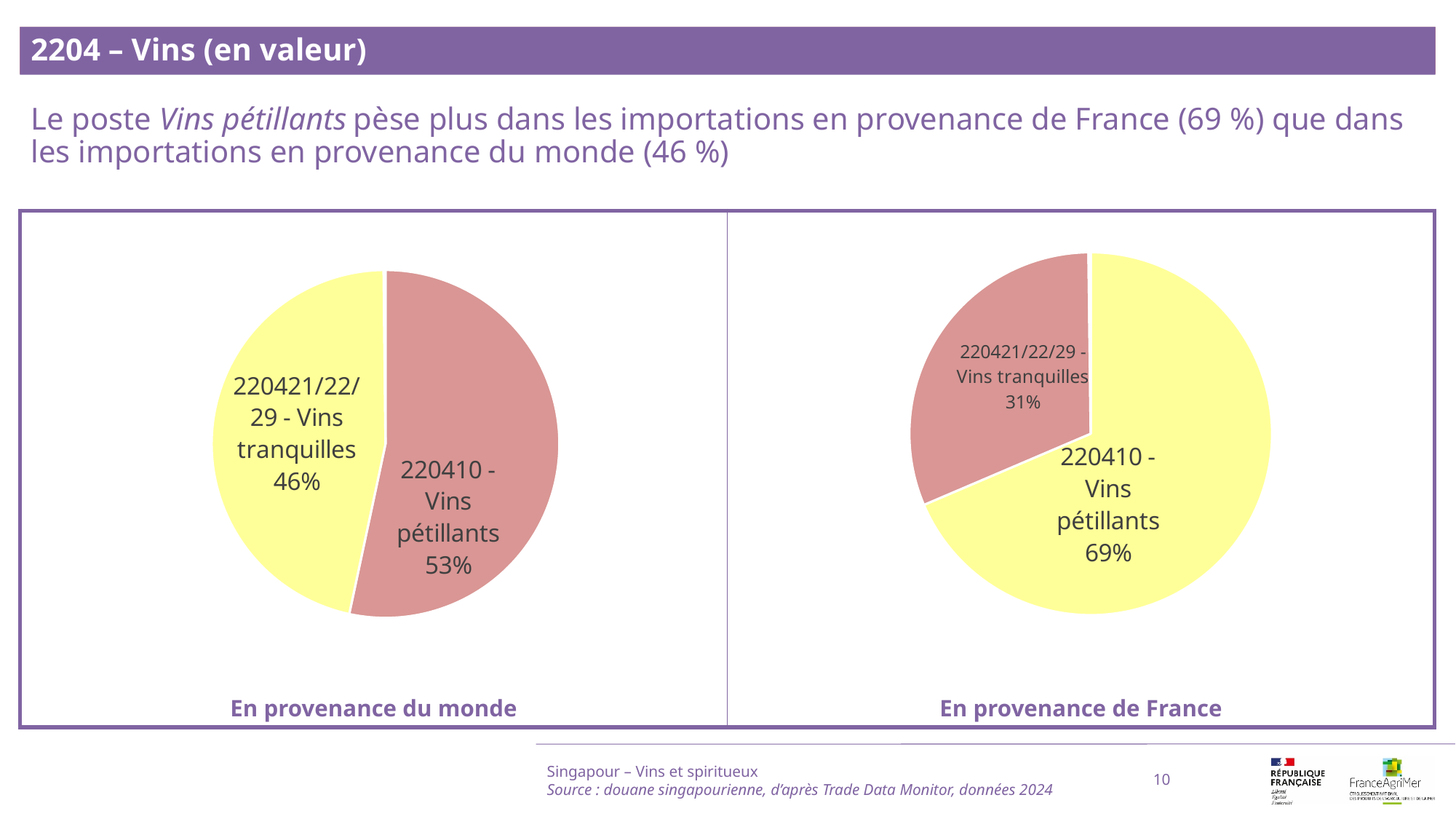
Is the share of Vins pétillants larger in the 'En provenance du monde' chart or in the 'En provenance de France' chart? En provenance de France What type of chart is the 'En provenance de France' chart? Pie chart In the 'En provenance de France' chart, what share does '220421/22/29 - Vins tranquilles' have? 31% In the 'En provenance de France' chart, what is the difference in percentage points between Vins pétillants and Vins tranquilles? 38 In the 'En provenance du monde' chart, what colour is the Vins tranquilles slice? Yellow In the 'En provenance du monde' chart, which slice is the smallest? 220421/22/29 - Vins tranquilles In the 'En provenance de France' chart, which slice is the largest? 220410 - Vins pétillants What is the title of the chart on the right side of the slide? En provenance de France In the 'En provenance de France' chart, what share does '220410 - Vins pétillants' have? 69% How many slices does the 'En provenance du monde' chart have? 2 In the 'En provenance du monde' chart, what share does '220410 - Vins pétillants' have? 53% In the 'En provenance du monde' chart, what share does '220421/22/29 - Vins tranquilles' have? 46%